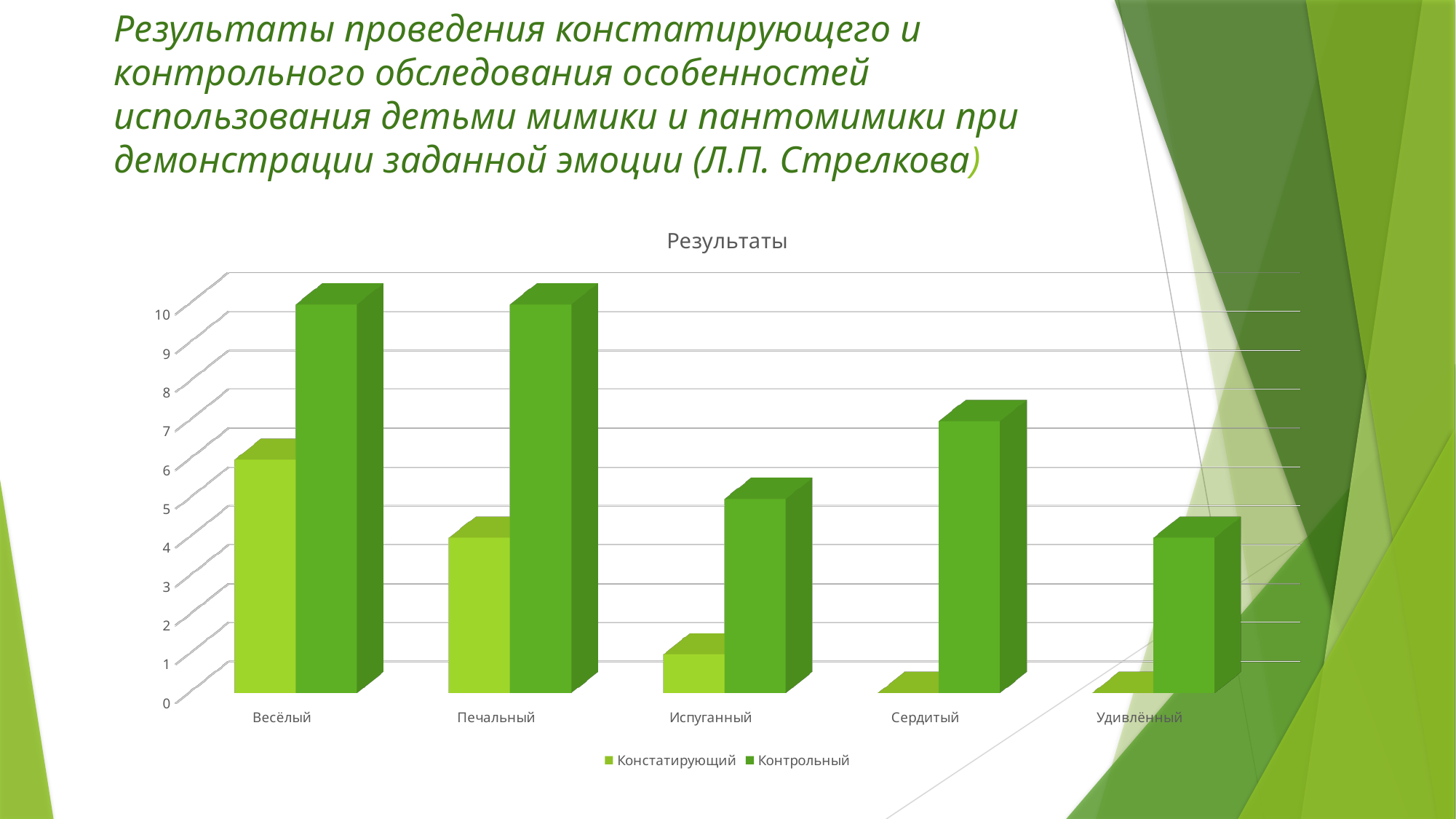
Which is larger: the Констатирующий value for Весёлый or the Констатирующий value for Печальный? Весёлый How many series does the legend list? 2 Which category has the lowest value for the Контрольный series? Удивлённый Is the Контрольный value for Весёлый greater or less than 8? greater What are the two series named in the legend? Констатирующий, Контрольный How many categories are shown on the x axis? 5 What kind of chart is shown on the slide? bar chart What is the title of the chart? Результаты Is the Констатирующий value for Испуганный greater or less than 3? less For Печальный, which series has the larger value, Констатирующий or Контрольный? Контрольный Is the Контрольный value for Сердитый greater or less than 5? greater Which category has the highest value for the Констатирующий series? Весёлый